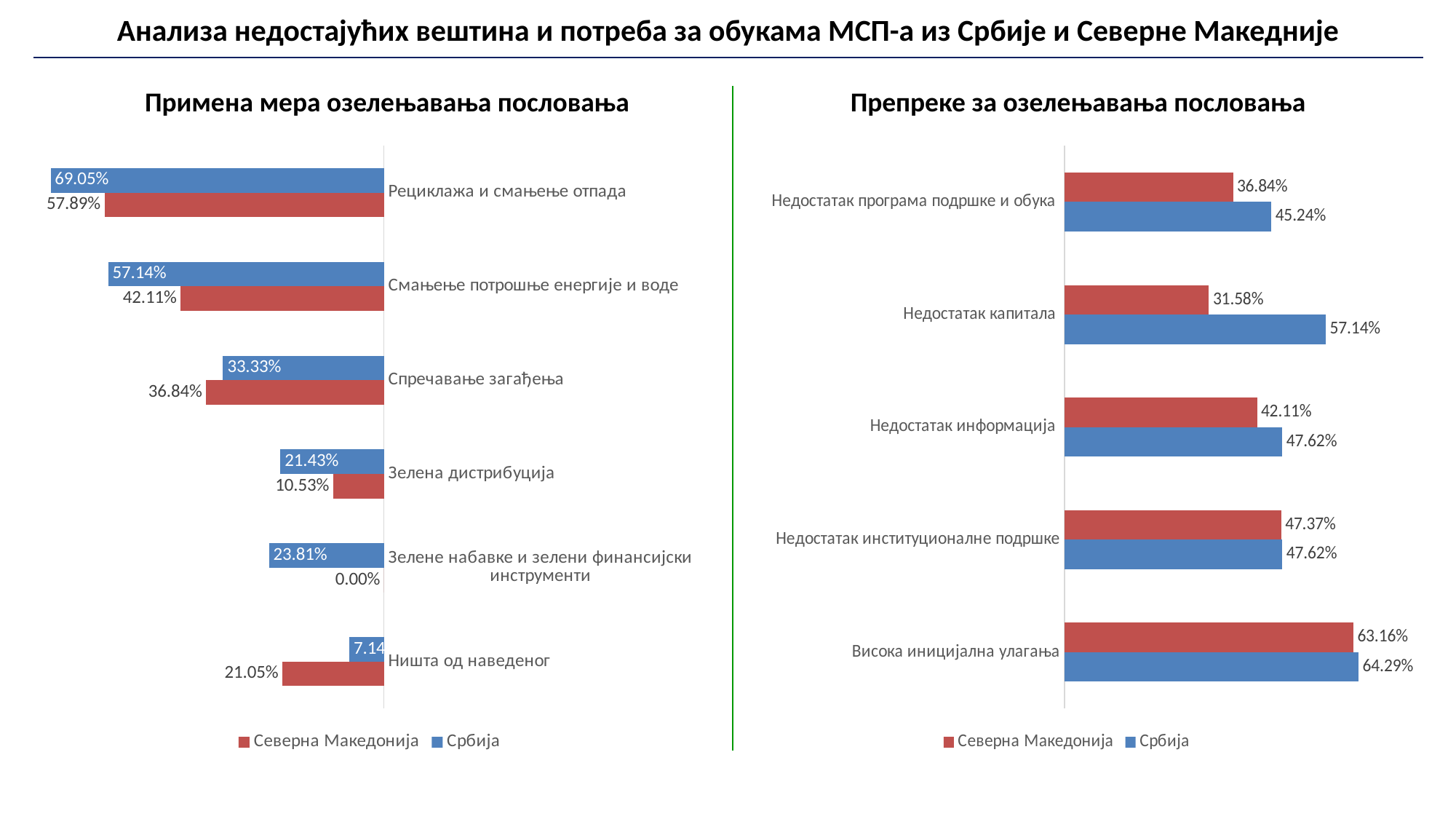
In the chart 'Препреке за озелењавања пословања', which is larger for 'Недостатак програма подршке и обука': Србија or Северна Македонија? Србија What type of chart is 'Препреке за озелењавања пословања'? Bar chart In the chart 'Примена мера озелењавања пословања', what is the value for Србија for 'Рециклажа и смањење отпада'? 69.05% In the chart 'Примена мера озелењавања пословања', how many categories are shown? 6 In the chart 'Препреке за озелењавања пословања', how many series does the legend list? 2 In the chart 'Препреке за озелењавања пословања', what is the value for Северна Македонија for 'Висока иницијална улагања'? 63.16% In the chart 'Примена мера озелењавања пословања', which category has the lowest value for Северна Македонија? Зелене набавке и зелени финансијски инструменти In the chart 'Примена мера озелењавања пословања', which category has the highest value for Србија? Рециклажа и смањење отпада In the chart 'Препреке за озелењавања пословања', what is the value for Србија for 'Недостатак капитала'? 57.14% In the chart 'Препреке за озелењавања пословања', which category has the lowest value for Северна Македонија? Недостатак капитала In the chart 'Примена мера озелењавања пословања', what is the value for Северна Македонија for 'Зелена дистрибуција'? 10.53% In the chart 'Примена мера озелењавања пословања', what is the difference between Србија and Северна Македонија for 'Смањење потрошње енергије и воде'? 15.03%